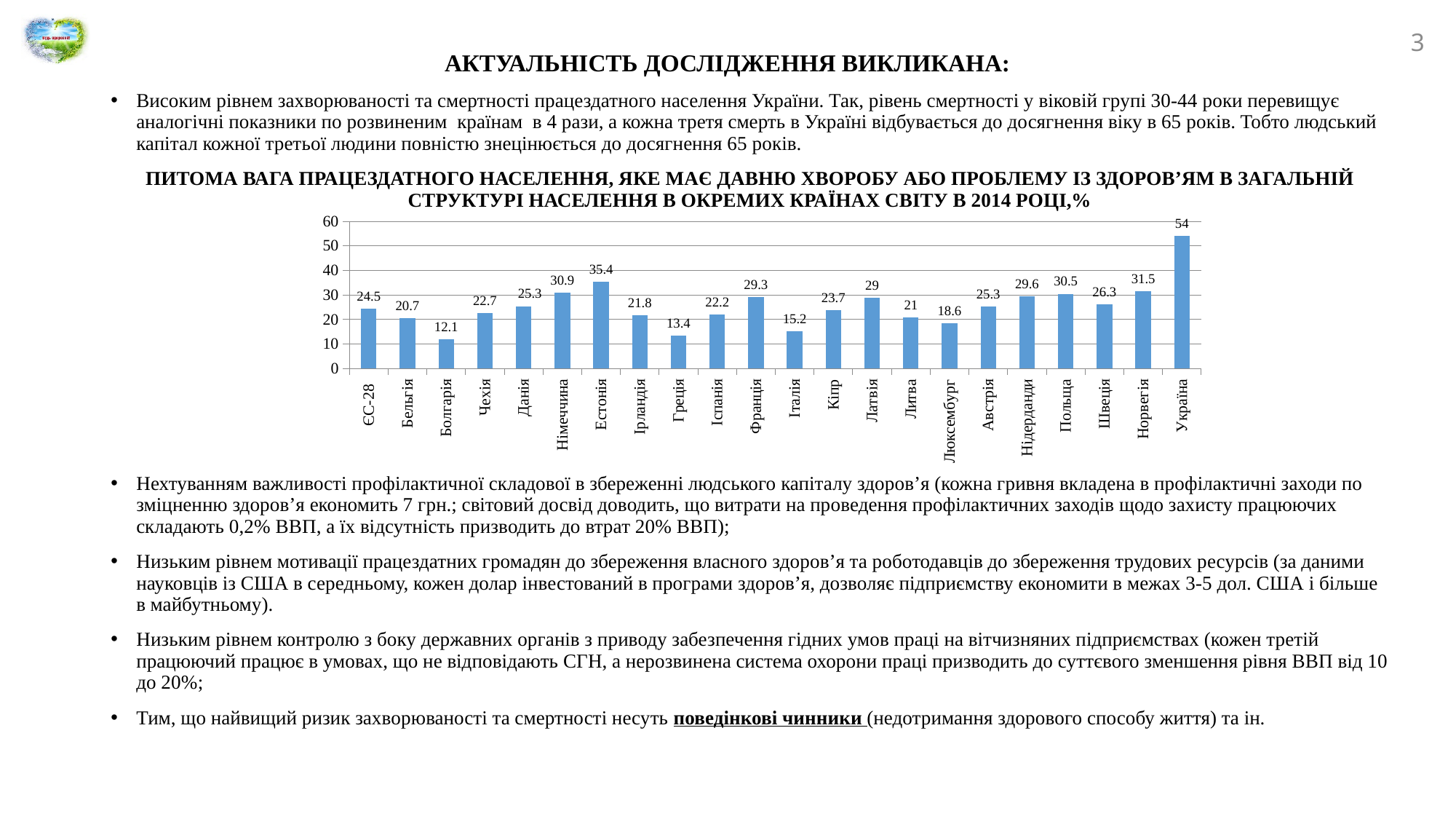
Which country has the highest value? Україна Is the value for Норвегія greater or less than 30? greater What is the difference between the values for Україна and ЄС-28? 29.5 What is the maximum value shown on the vertical axis? 60 What is the value for Естонія? 35.4 Which country has the lowest value? Болгарія What is the value for ЄС-28? 24.5 What is the value for Україна? 54 What kind of chart is shown on the slide? bar chart What is the value for Люксембург? 18.6 How many countries/categories are shown on the x axis? 22 Which is larger, the value for Німеччина or the value for Франція? Німеччина